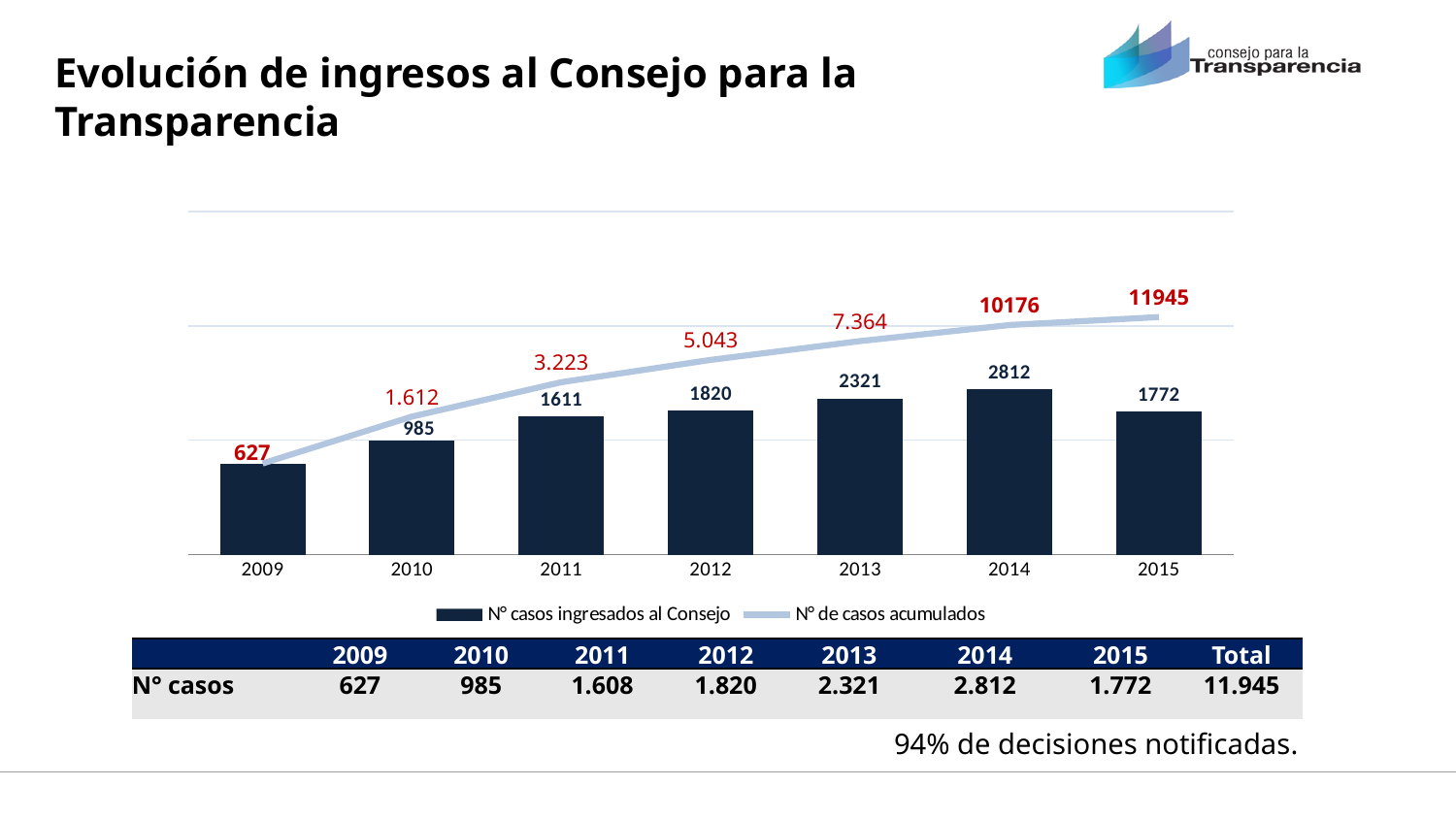
Which year has the lowest value for N° casos ingresados al Consejo? 2009 Does the N° de casos acumulados line rise or fall from 2009 to 2015? rise Which series in the chart is drawn as a line? N° de casos acumulados How many years are shown on the x axis of the chart? 7 What is the value of N° de casos acumulados for 2013? 7.364 What is the value of N° casos ingresados al Consejo for 2009? 627 What is the value of N° casos ingresados al Consejo for 2014? 2812 Which year has the highest value for N° casos ingresados al Consejo? 2014 What is the value of N° de casos acumulados for 2015? 11945 What is the difference between the N° casos ingresados al Consejo values for 2014 and 2015? 1040 How many series does the chart legend list? 2 Which is larger, the N° casos ingresados al Consejo value for 2012 or for 2013? 2013